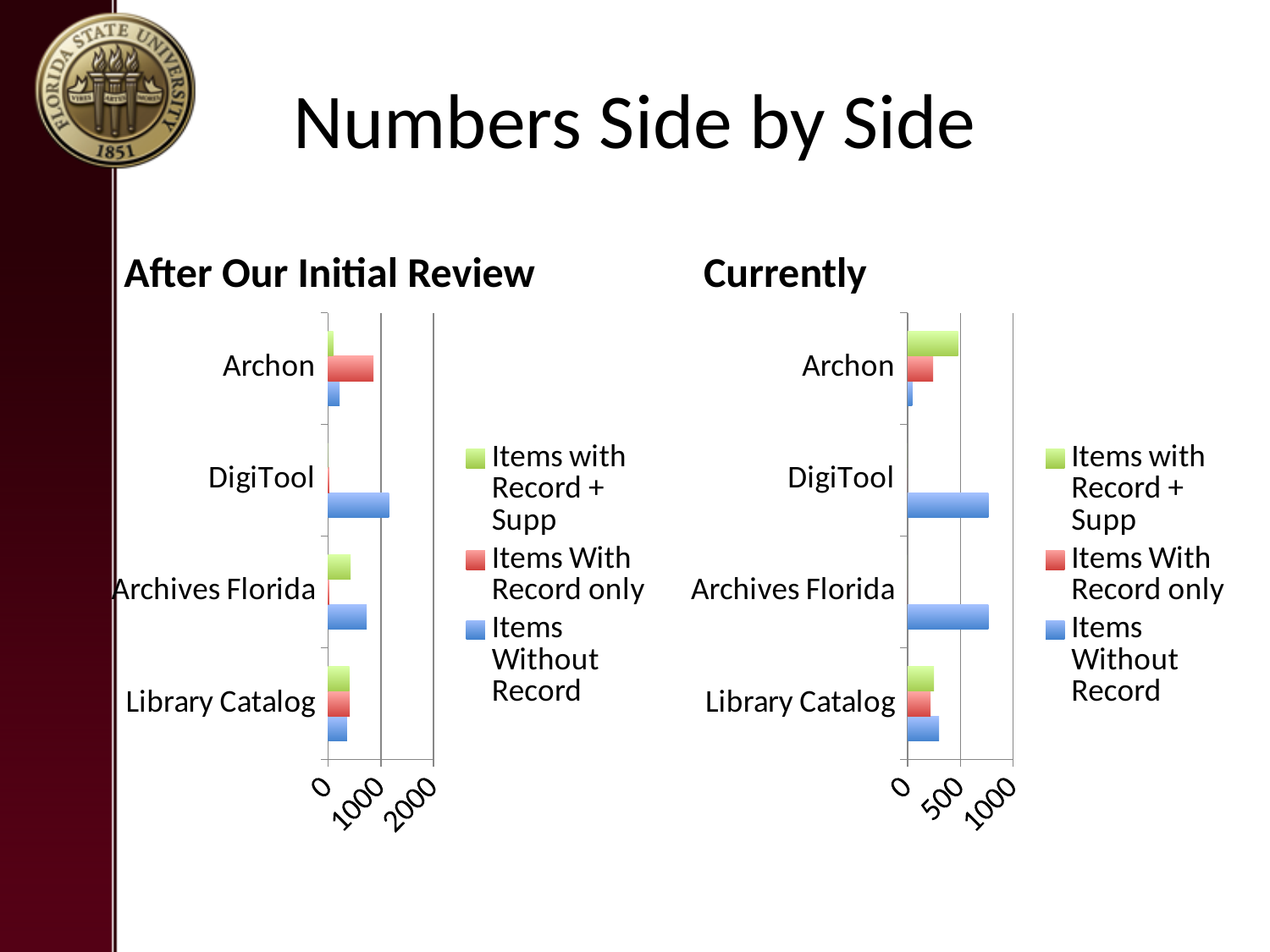
In the "Currently" chart, is the "Items Without Record" value for Library Catalog greater or less than 500? less How many categories are shown on the "Currently" chart? 4 In the "After Our Initial Review" chart, which category has the longest "Items Without Record" bar? DigiTool In the "Currently" chart, which category has the longest "Items with Record + Supp" bar? Archon How many series does the legend of the "After Our Initial Review" chart list? 3 In the "After Our Initial Review" chart, is the "Items With Record only" value for Archon greater or less than 1000? less In the "Currently" chart, for Archon, which is larger: "Items with Record + Supp" or "Items With Record only"? Items with Record + Supp In the "Currently" chart, is the "Items Without Record" value for DigiTool greater or less than 500? greater In the "After Our Initial Review" chart, for Archon, which is larger: "Items With Record only" or "Items Without Record"? Items With Record only In the "After Our Initial Review" chart, which category has the longest "Items With Record only" bar? Archon What type of chart is the "After Our Initial Review" chart? bar chart